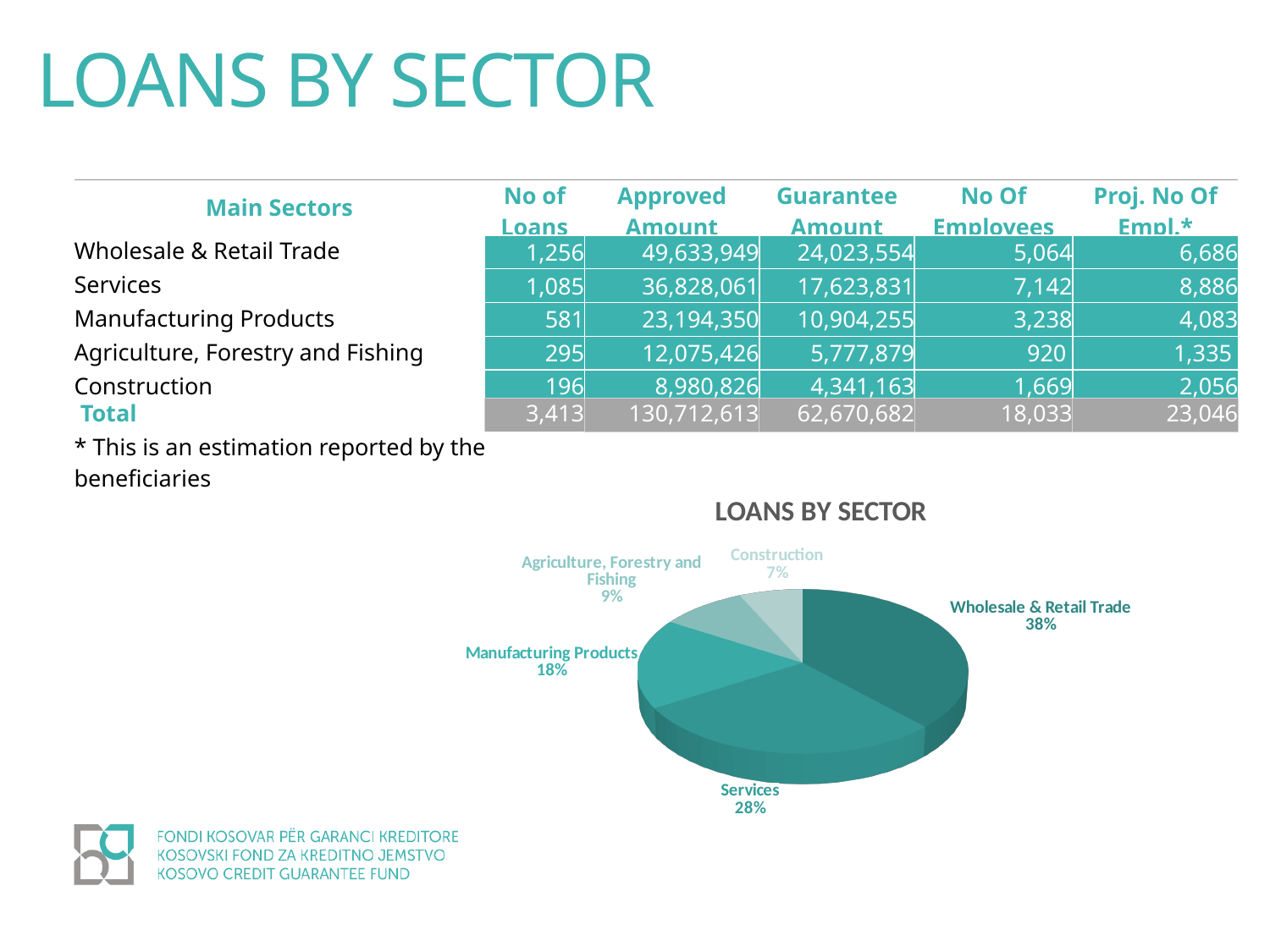
What is the title of the chart? LOANS BY SECTOR What share of the pie does Services have? 28% How many slices does the pie chart have? 5 What is the difference in percentage points between the Wholesale & Retail Trade slice and the Services slice? 10 Which sector has the largest slice of the pie? Wholesale & Retail Trade What share of the pie does Wholesale & Retail Trade have? 38% What share of the pie does Construction have? 7% What kind of chart is shown on the slide? pie chart Which slice is larger, Manufacturing Products or Agriculture, Forestry and Fishing? Manufacturing Products Which sector has the smallest slice of the pie? Construction